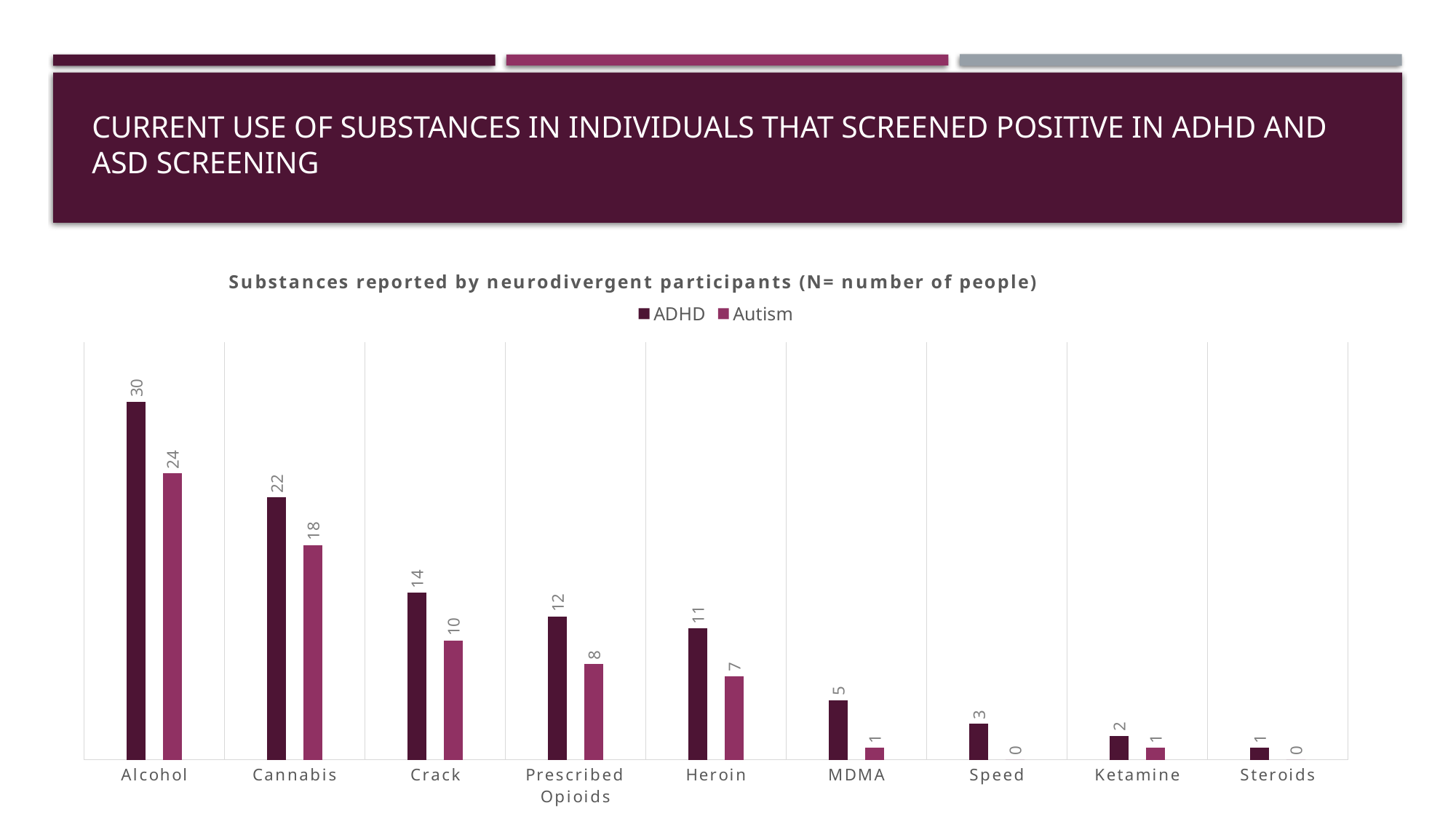
How many series does the legend list? 2 What is the ADHD value for Alcohol? 30 What is the difference between the ADHD and Autism values for Crack? 4 What is the title of the chart? Substances reported by neurodivergent participants (N= number of people) Which is larger for Heroin, the ADHD value or the Autism value? ADHD Which substance has the highest ADHD value? Alcohol What is the Autism value for Cannabis? 18 What kind of chart is shown on the slide? Bar chart Do the ADHD values rise or fall from Alcohol to Steroids along the x axis? Fall What is the Autism value for Speed? 0 Which substance has the lowest Autism value? Speed and Steroids (both 0) How many substance categories are shown on the x axis? 9